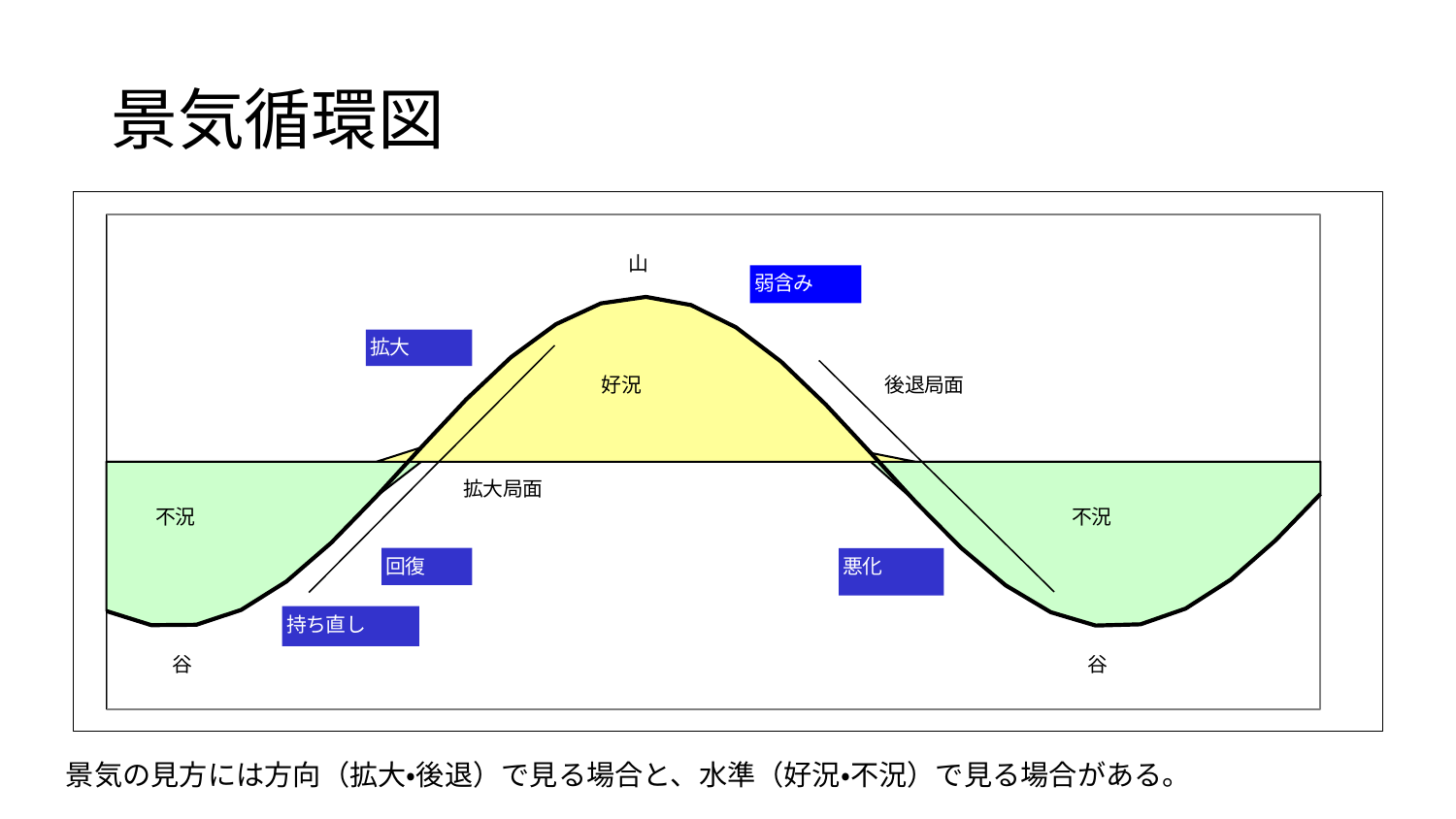
What label is written inside the green shaded areas below the horizontal line? 不況 What label is placed along the rising slope of the curve? 拡大局面 What label is written inside the yellow shaded area above the horizontal line? 好況 What colour is the shaded area labelled 好況? yellow Moving from the left 谷 to 山, does the curve rise or fall? rise What label marks the troughs of the curve? 谷 What is the title of the diagram on the slide? 景気循環図 What label marks the peak of the curve? 山 Moving from 山 to the right 谷, does the curve rise or fall? fall What label is placed along the falling slope of the curve? 後退局面 How many green 不況 regions are shaded in the diagram? 2